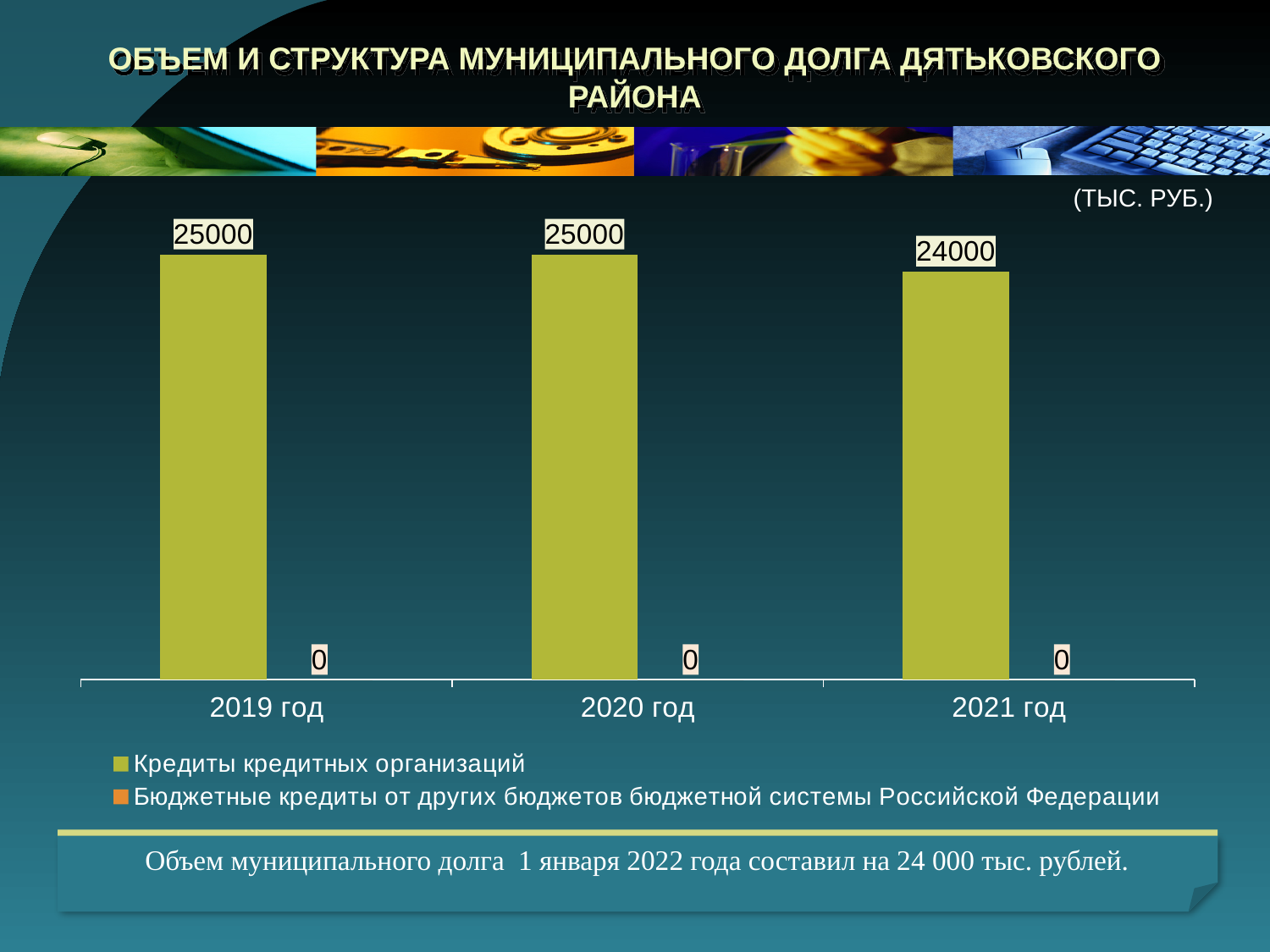
Which is larger: the Кредиты кредитных организаций value for 2019 год or for 2021 год? 2019 год What is the value for Кредиты кредитных организаций in 2019 год? 25000 What kind of chart is shown on the slide? Bar chart What is the value for Кредиты кредитных организаций in 2021 год? 24000 What is the value for Бюджетные кредиты от других бюджетов бюджетной системы Российской Федерации in 2020 год? 0 What unit is indicated for the chart values? ТЫС. РУБ. How many years (categories) are shown on the x axis? 3 What is the difference between the Кредиты кредитных организаций values for 2020 год and 2021 год? 1000 In which year is the value for Кредиты кредитных организаций lowest? 2021 год How many series does the legend list? 2 What is the total of the two series for 2021 год? 24000 Does the value for Кредиты кредитных организаций rise or fall from 2020 год to 2021 год? Fall